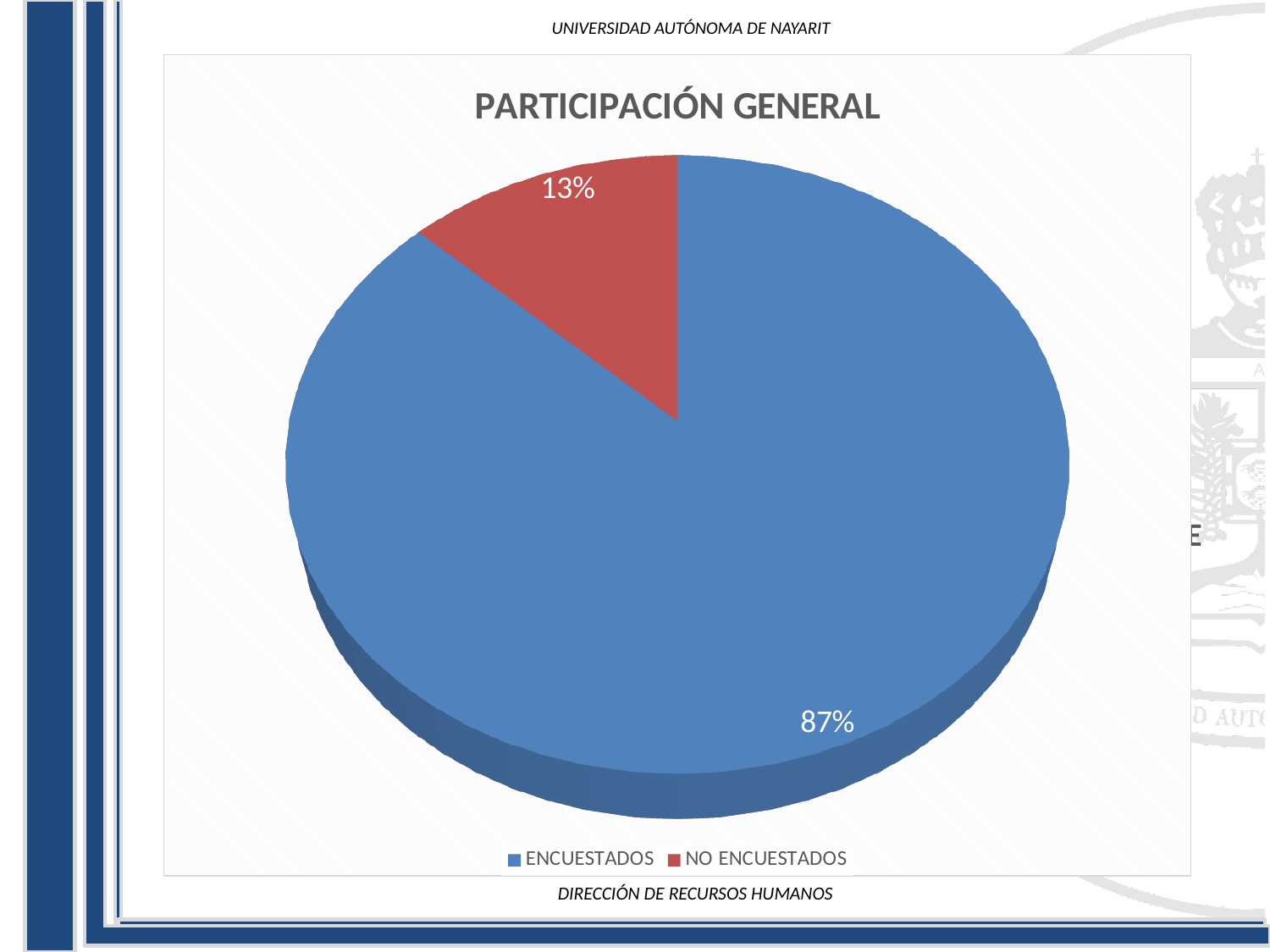
What is the title of the chart? PARTICIPACIÓN GENERAL Which category has the largest share of the pie? ENCUESTADOS What share of the pie does the red slice represent? 13% What percentage of the pie is NO ENCUESTADOS? 13% Which category has the smallest share of the pie? NO ENCUESTADOS Which is larger, the share for ENCUESTADOS or for NO ENCUESTADOS? ENCUESTADOS What type of chart is shown on the slide? Pie chart How many categories does the legend list? 2 What is the difference in percentage points between ENCUESTADOS and NO ENCUESTADOS? 74 What colour is the ENCUESTADOS slice? Blue What percentage of the pie is ENCUESTADOS? 87%